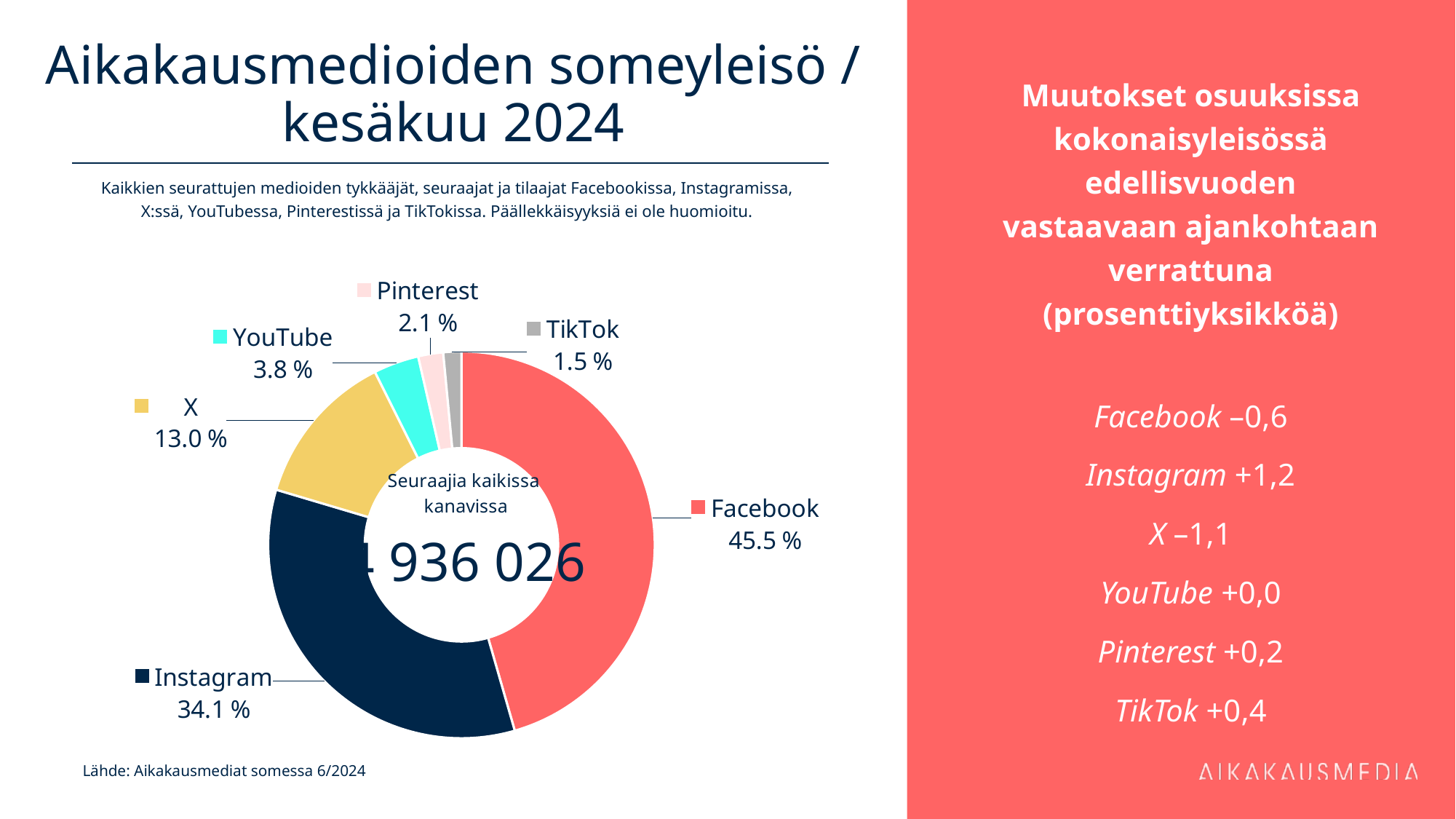
What share of the social media audience does TikTok have? 1.5 % Which channel has the largest share of the audience? Facebook What kind of chart is shown on the slide? Doughnut (pie) chart What share of the social media audience does Facebook have? 45.5 % Which has a larger share, X or YouTube? X How many channels are shown in the chart? 6 What share of the social media audience does X have? 13.0 % Which channel has the smallest share of the audience? TikTok What share of the social media audience does YouTube have? 3.8 % What share of the social media audience does Instagram have? 34.1 % What is the difference in percentage points between Facebook's and Instagram's shares? 11.4 What colour is the Instagram segment in the chart? Dark navy blue